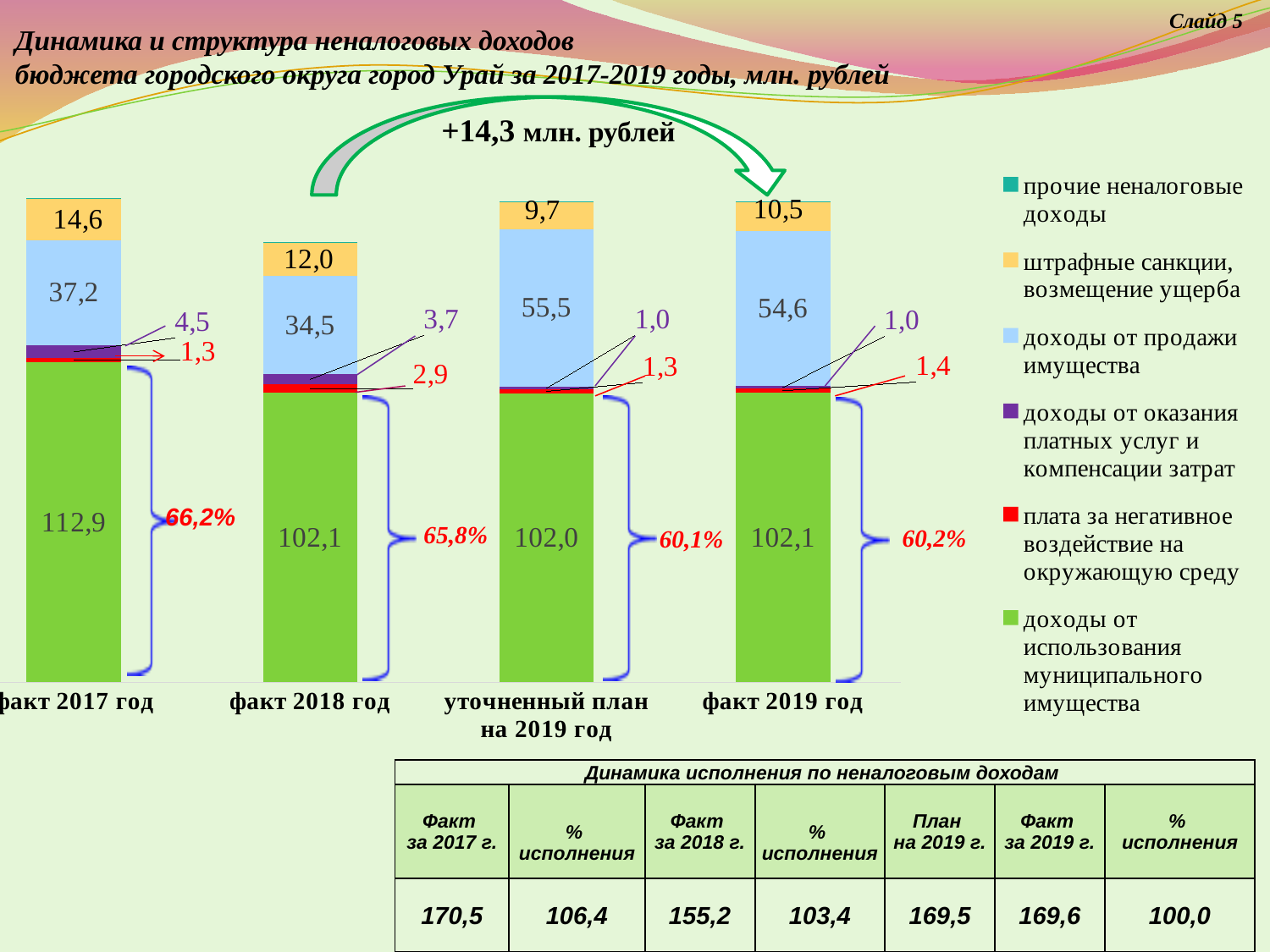
How many categories are shown on the x axis of the chart? 4 What is the difference between доходы от продажи имущества for факт 2019 год and факт 2018 год? 20,1 What is the value of штрафные санкции, возмещение ущерба for факт 2018 год? 12,0 Which is larger: доходы от оказания платных услуг и компенсации затрат for факт 2017 год or for факт 2018 год? факт 2017 год What is the value of плата за негативное воздействие на окружающую среду for факт 2019 год? 1,4 What is the total of the stacked bar for факт 2018 год? 155,2 Which category has the lowest value for штрафные санкции, возмещение ущерба? уточненный план на 2019 год What kind of chart is shown on the slide? stacked bar chart What is the value of доходы от продажи имущества for уточненный план на 2019 год? 55,5 Which category has the highest value for доходы от использования муниципального имущества? факт 2017 год How many series does the chart legend list? 6 What is the value of доходы от использования муниципального имущества for факт 2017 год? 112,9